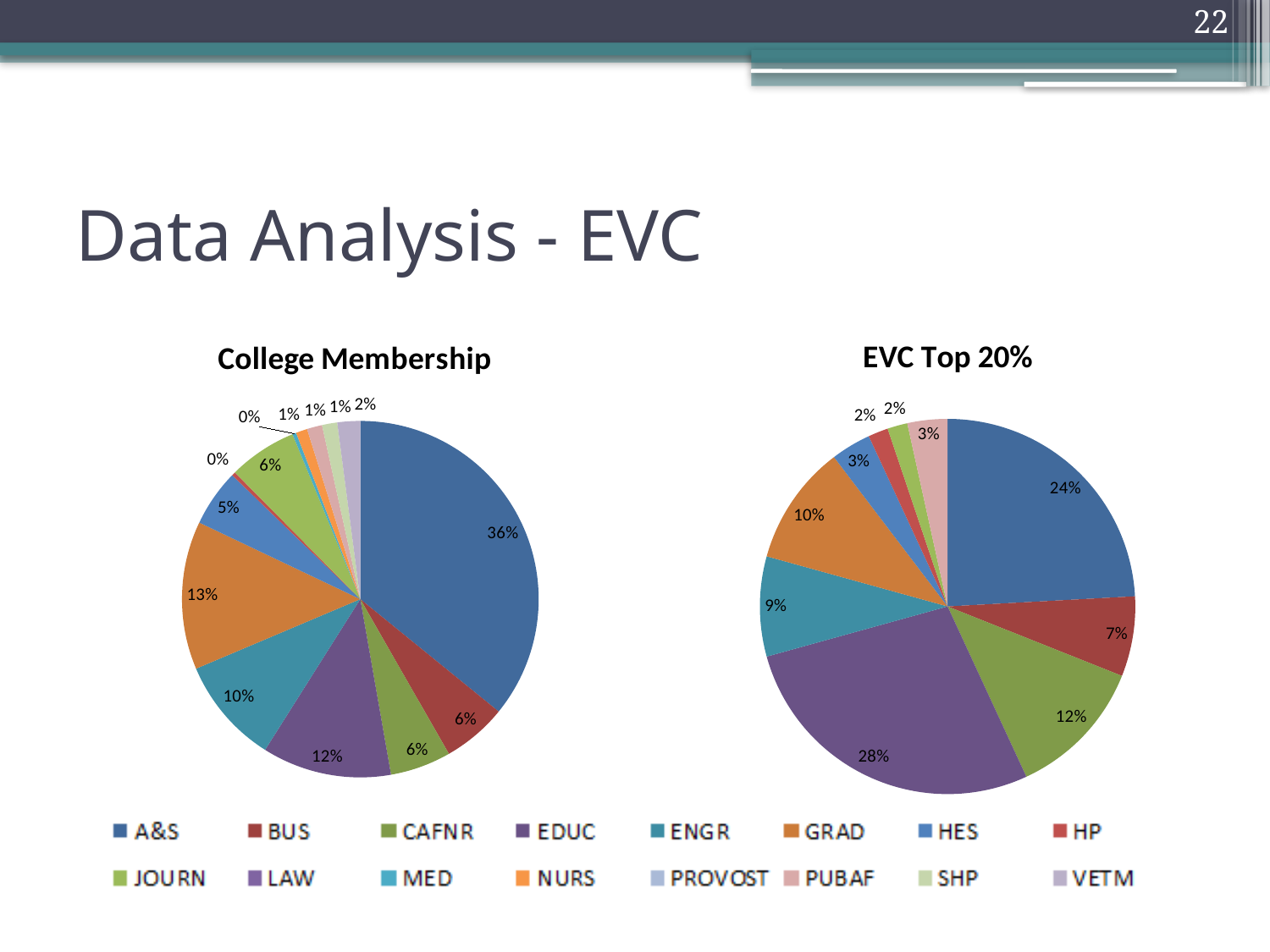
In the EVC Top 20% chart, what is the largest slice's share? 28% How many entries does the legend list? 16 What is the title of the chart on the right? EVC Top 20% In the College Membership chart, what share does A&S have? 36% What kind of charts are shown on the slide? Pie charts Which is larger: the A&S share in the College Membership chart or the A&S share in the EVC Top 20% chart? College Membership In the College Membership chart, what share does GRAD have? 13% In the EVC Top 20% chart, what share does CAFNR have? 12% In the EVC Top 20% chart, what share does BUS have? 7% In the EVC Top 20% chart, what is the difference between the A&S share and the BUS share? 17% In the EVC Top 20% chart, what share does A&S have? 24% In the College Membership chart, which college has the largest share? A&S